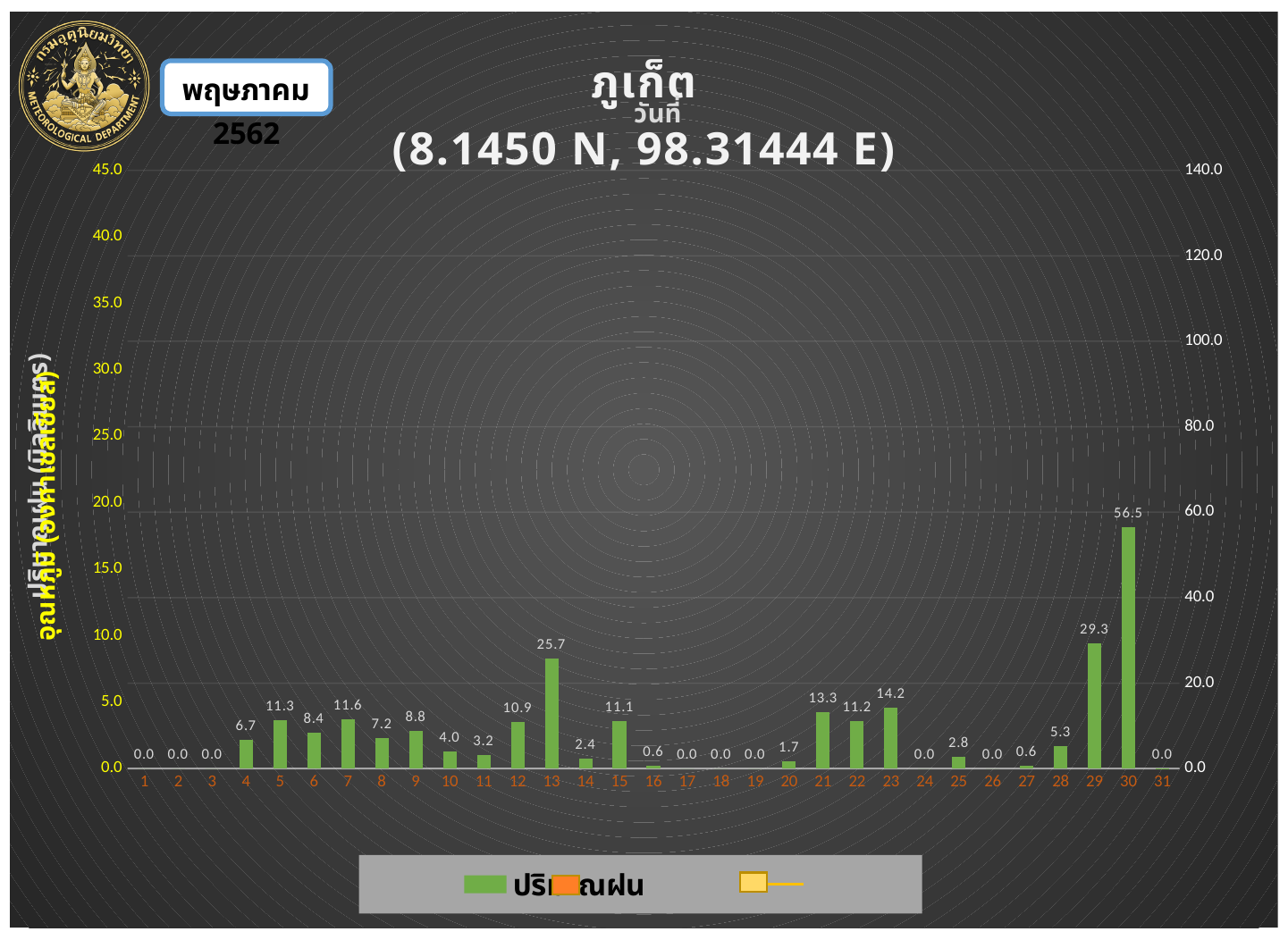
What is the difference between the values for day 30 and day 29? 27.2 What coordinates are given in the chart title? 8.1450 N, 98.31444 E How many days are shown on the x axis? 31 Which is larger, the value for day 5 or the value for day 6? day 5 What is the value for day 23? 14.2 What is the value for day 30? 56.5 Which day has the highest value? 30 What kind of chart is shown on the slide? bar chart Which is larger, the value for day 21 or the value for day 22? day 21 What is the difference between the values for day 13 and day 12? 14.8 What is the value for day 13? 25.7 What is the value for day 4? 6.7